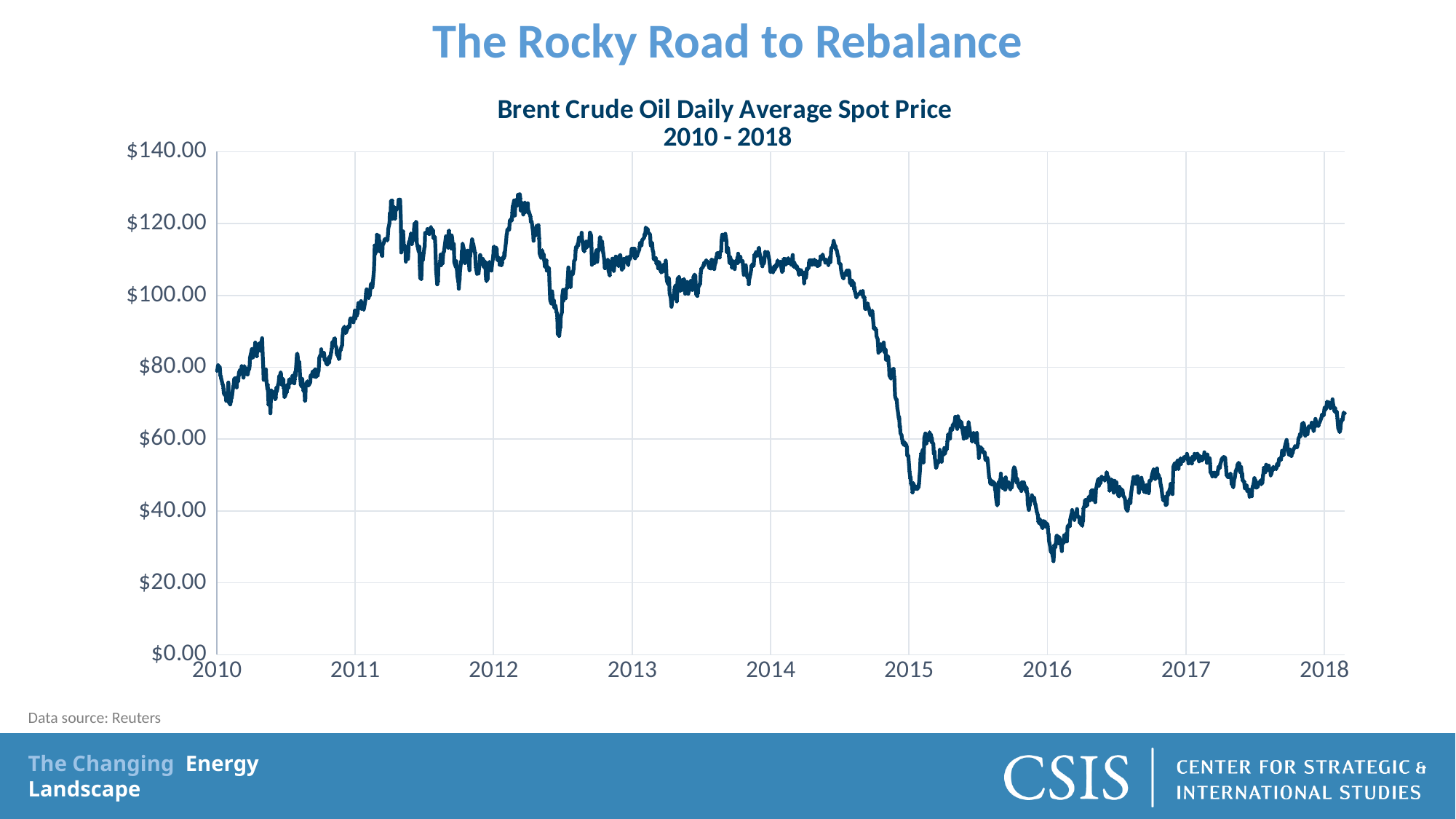
Between the start of 2014 and the start of 2016, does the price rise or fall? fall How many year labels are shown on the x axis? 9 Is the price at the start of 2012 greater or less than $100.00? greater Is the price at the start of 2016 greater or less than $60.00? less What is the highest value labelled on the y axis? $140.00 Is the price at the start of 2017 greater or less than $80.00? less Between the start of 2016 and the start of 2018, does the price rise or fall? rise What is the title of the chart? Brent Crude Oil Daily Average Spot Price 2010 - 2018 In which year does the line reach its lowest point? 2016 What kind of chart is shown on the slide? line chart What data source is cited for the chart? Reuters